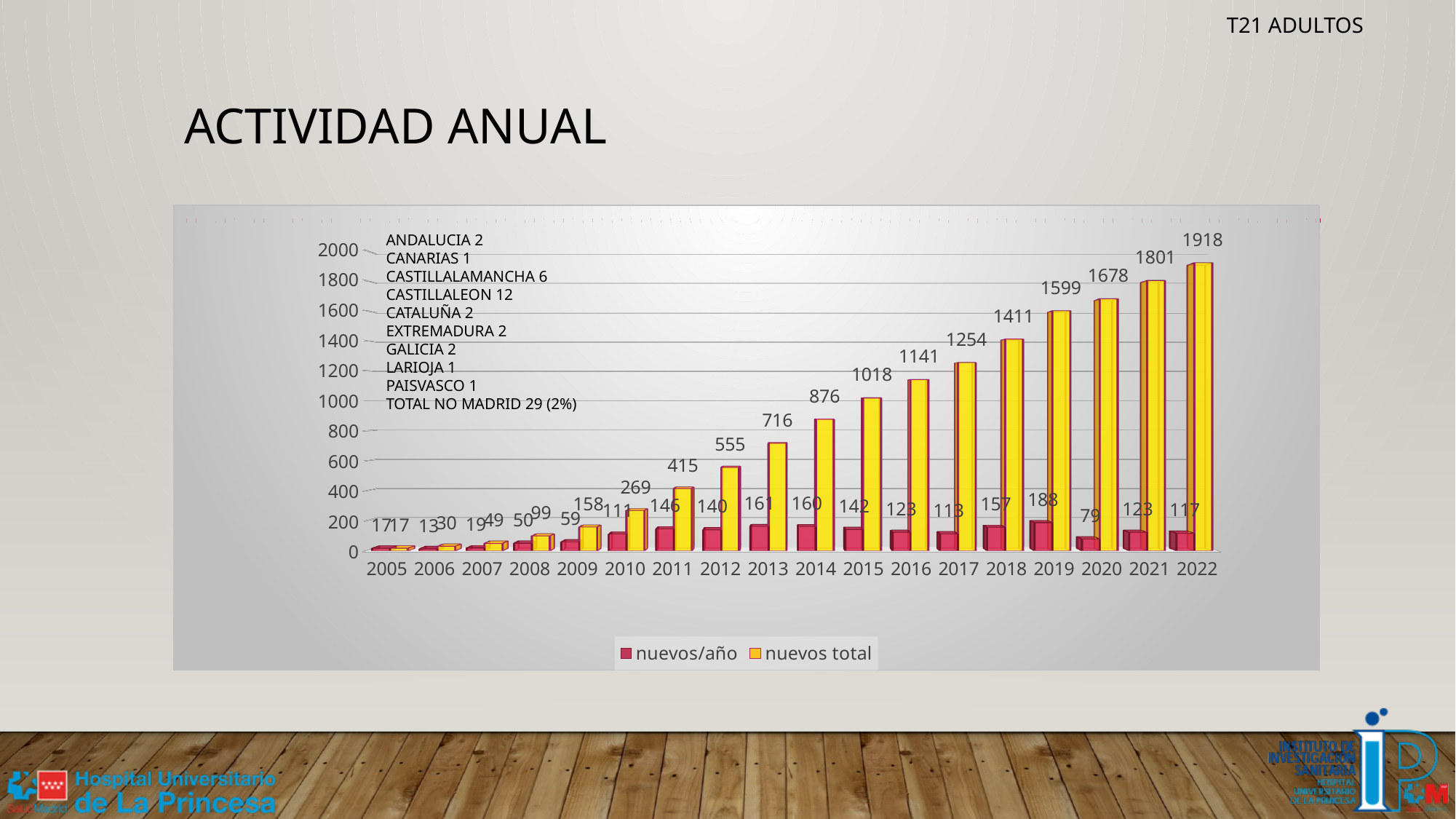
Which year has the highest value for 'nuevos/año'? 2019 What is the value of 'nuevos total' for 2013? 716 What is the value of 'nuevos/año' for 2019? 188 Does the 'nuevos total' series rise or fall from 2005 to 2022? Rises How many series does the legend list? 2 What is the value of 'nuevos total' for 2022? 1918 What is the difference between the 'nuevos total' values for 2022 and 2021? 117 What is the title of the slide containing the chart? ACTIVIDAD ANUAL How many years are shown on the x axis? 18 What kind of chart is shown on the slide? Bar chart Which is larger, the 'nuevos/año' value for 2020 or for 2021? 2021 Which year has the lowest value for 'nuevos/año'? 2006